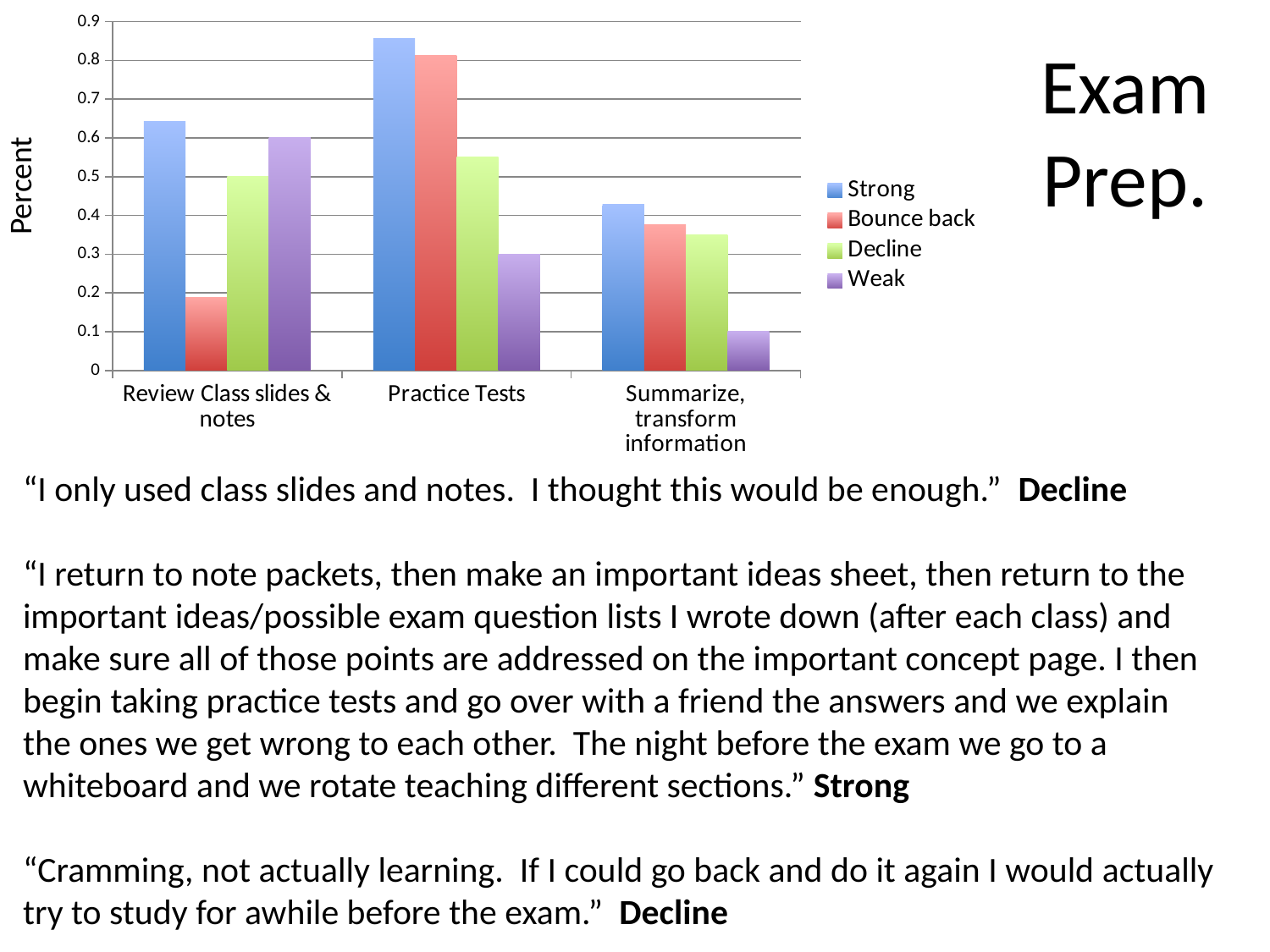
For Review Class slides & notes, which is larger: the Strong value or the Bounce back value? Strong Is the Bounce back value for Review Class slides & notes greater or less than 0.3? less For Practice Tests, which is larger: the Decline value or the Weak value? Decline Is the Strong value for Practice Tests greater or less than 0.8? greater Is the Weak value for Summarize, transform information greater or less than 0.2? less Which category has the lowest Weak value? Summarize, transform information Which category has the highest Strong value? Practice Tests What kind of chart is shown on the slide? bar chart How many series does the legend list? 4 What is the label on the y axis of the chart? Percent How many categories are shown on the x axis? 3 Which category has the lowest Bounce back value? Review Class slides & notes